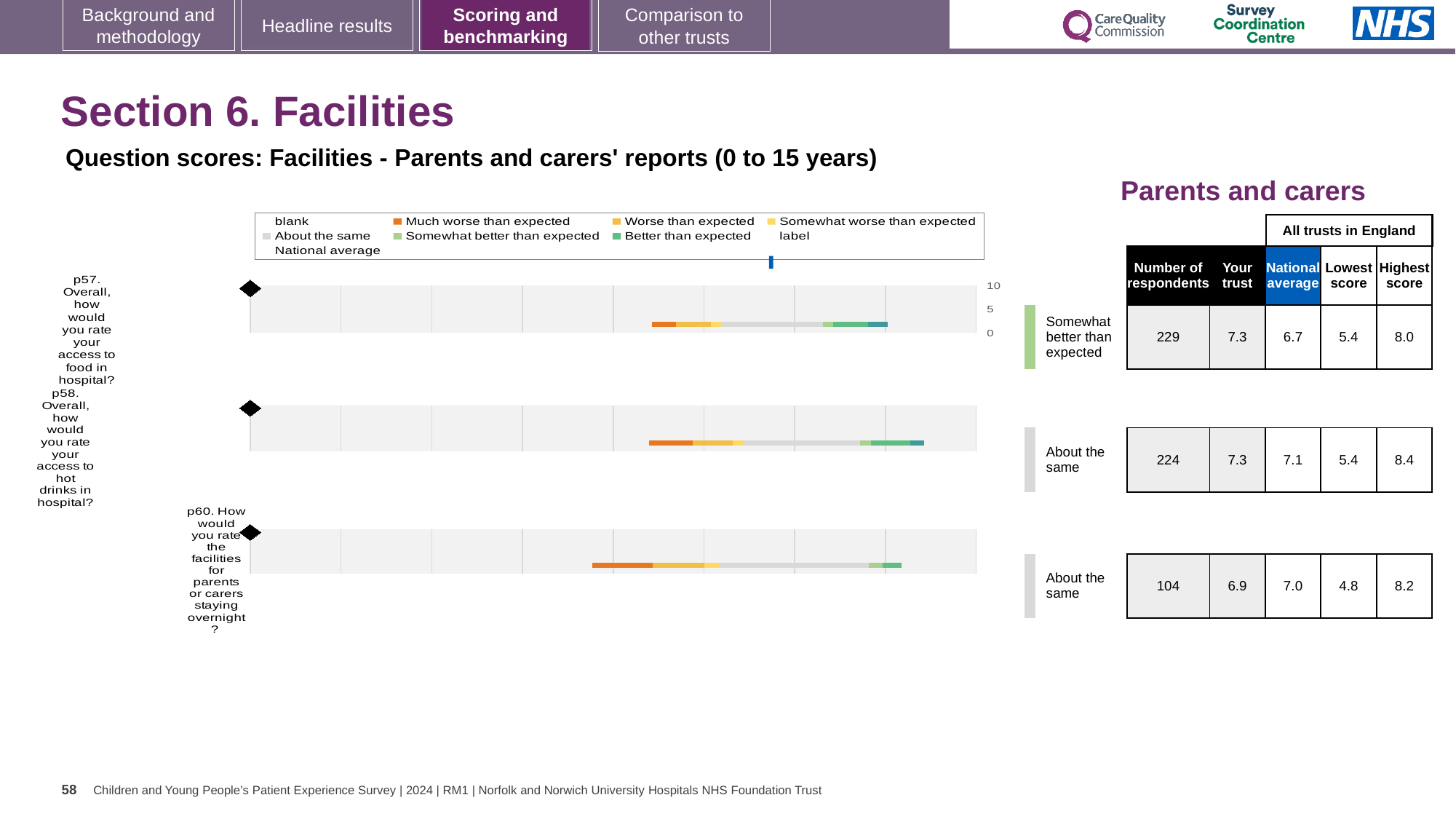
How many questions are plotted in the Facilities chart? 3 What benchmark category is shown for p57 (access to food in hospital)? Somewhat better than expected In the chart legend, what colour represents 'Much worse than expected'? orange For p57, how much higher is the 'Your trust' score than the national average? 0.6 How many respondents answered p57 (access to food in hospital)? 229 For p60, which is larger: the 'Your trust' score or the national average? National average Which question has the lowest 'Lowest score' across all trusts in England? p60 (4.8) What kind of chart is used to show the question scores for Facilities? bar chart What is the 'Your trust' score for p58 (access to hot drinks in hospital)? 7.3 What is the national average for p60 (facilities for parents or carers staying overnight)? 7.0 What is the highest value shown on the chart's score axis? 10 Which question has the highest 'Highest score' across all trusts in England? p58 (8.4)